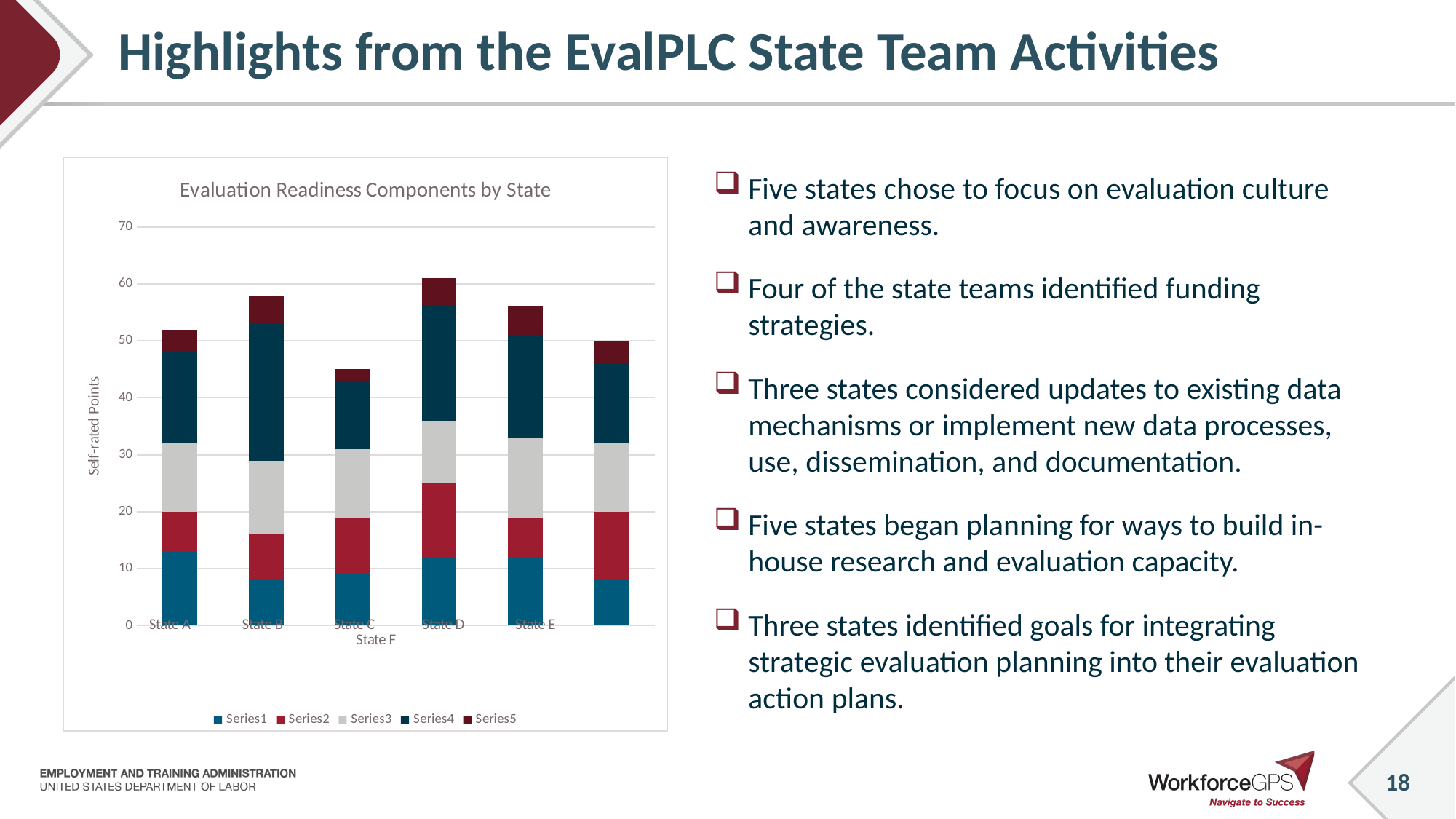
Is the total stacked value for State B greater or less than 50? greater What is the title of the chart? Evaluation Readiness Components by State Which has the larger total stacked bar, State B or State C? State B Which state has the tallest stacked bar in total? State D Is the total stacked value for State F greater or less than 60? less What kind of chart is shown on the slide? stacked bar chart How many series does the chart legend list? 5 How many states (categories) are plotted on the chart? 6 Is the total stacked value for State C greater or less than 50? less What is the label on the vertical axis of the chart? Self-rated Points Which state has the shortest stacked bar in total? State C